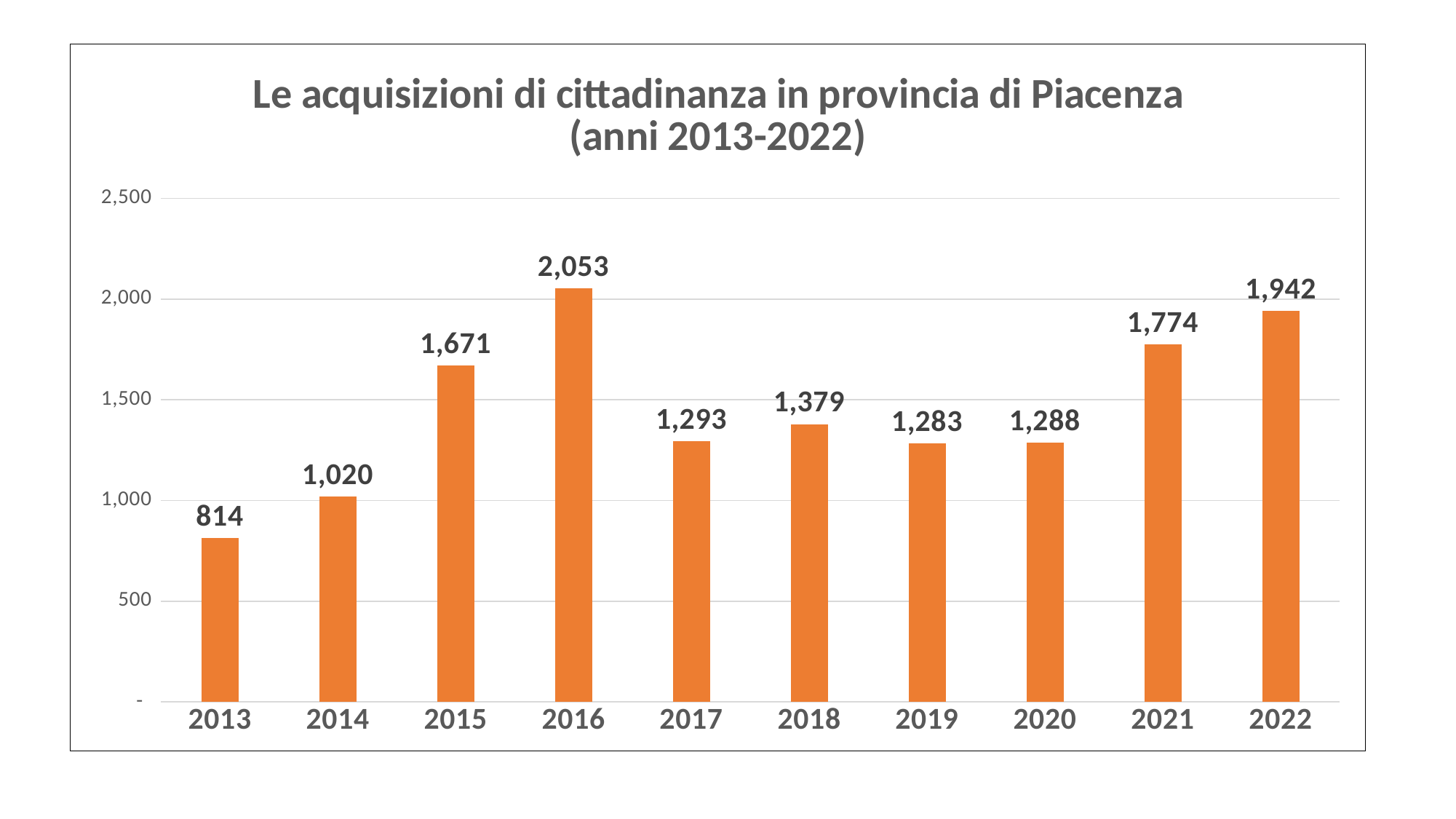
What is the value for 2021? 1,774 What is the value for 2013? 814 Which is larger, the value for 2015 or the value for 2018? 2015 Which year has the highest value? 2016 Is the value for 2014 greater or less than 1,500? less What is the difference between the values for 2016 and 2017? 760 How many years are shown on the x axis? 10 What is the difference between the values for 2022 and 2021? 168 What is the title of the chart? Le acquisizioni di cittadinanza in provincia di Piacenza (anni 2013-2022) What kind of chart is shown? bar chart What is the value for 2016? 2,053 Which year has the lowest value? 2013